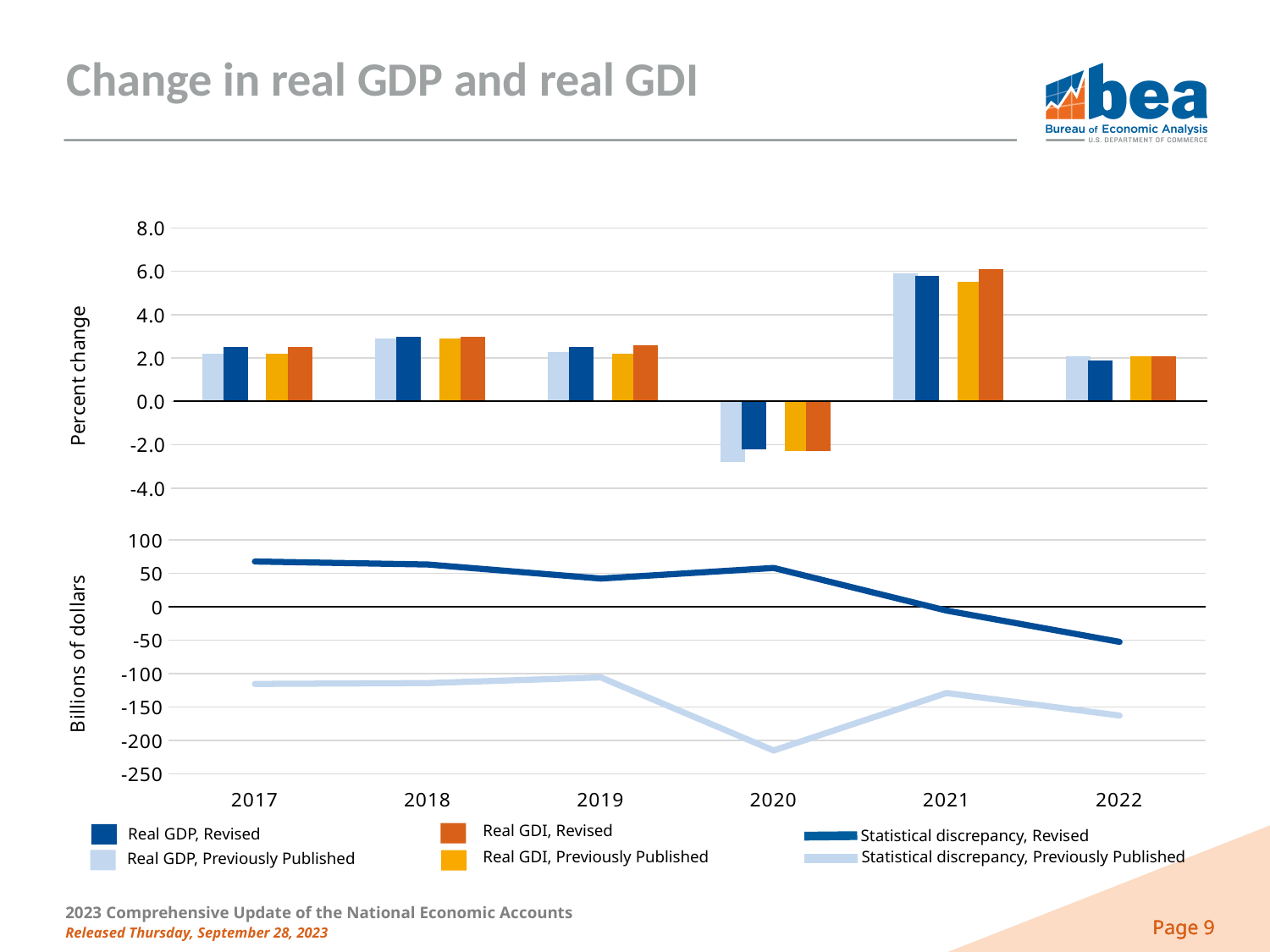
In the bottom line chart, which year has the lowest value for Statistical discrepancy, Previously Published? 2020 In the bottom line chart, is the value for Statistical discrepancy, Previously Published in 2020 greater or less than -200? less In the bottom line chart, does the Statistical discrepancy, Revised line rise or fall from 2020 to 2022? fall In the top bar chart, is the value for Real GDP, Revised in 2021 greater or less than 4.0? greater What kind of chart is the bottom chart (Billions of dollars)? line chart In the top bar chart, is the value for Real GDP, Previously Published in 2020 greater or less than -2.0? less What kind of chart is the top chart (Percent change)? bar chart How many years are shown on the x axis? 6 In the top bar chart, which year has the lowest value for Real GDI, Revised? 2020 In the top bar chart, which year has the highest value for Real GDP, Revised? 2021 How many series does the legend list in total across both charts? 6